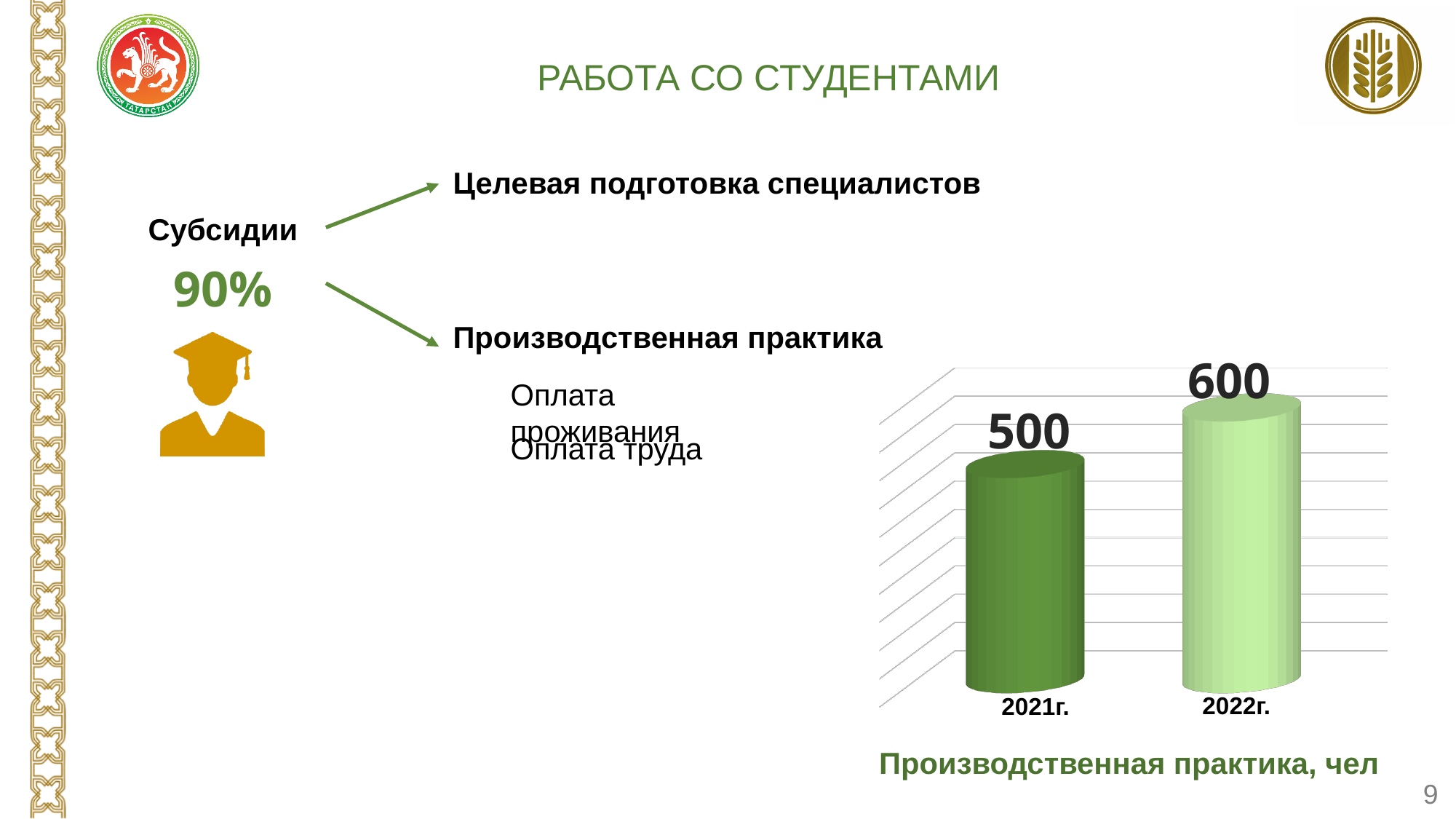
What is the value for 2022г. in the chart? 600 Do the values rise or fall from 2021г. to 2022г.? rise Which is larger, the value for 2021г. or for 2022г.? 2022г. What kind of chart is shown on the slide? bar chart What is the difference between the values for 2022г. and 2021г.? 100 Which year has the highest value in the chart? 2022г. What is the value for 2021г. in the chart? 500 Which year has the lowest value in the chart? 2021г. How many categories are shown in the chart? 2 What is the caption below the chart? Производственная практика, чел What is the total of the values for 2021г. and 2022г.? 1100